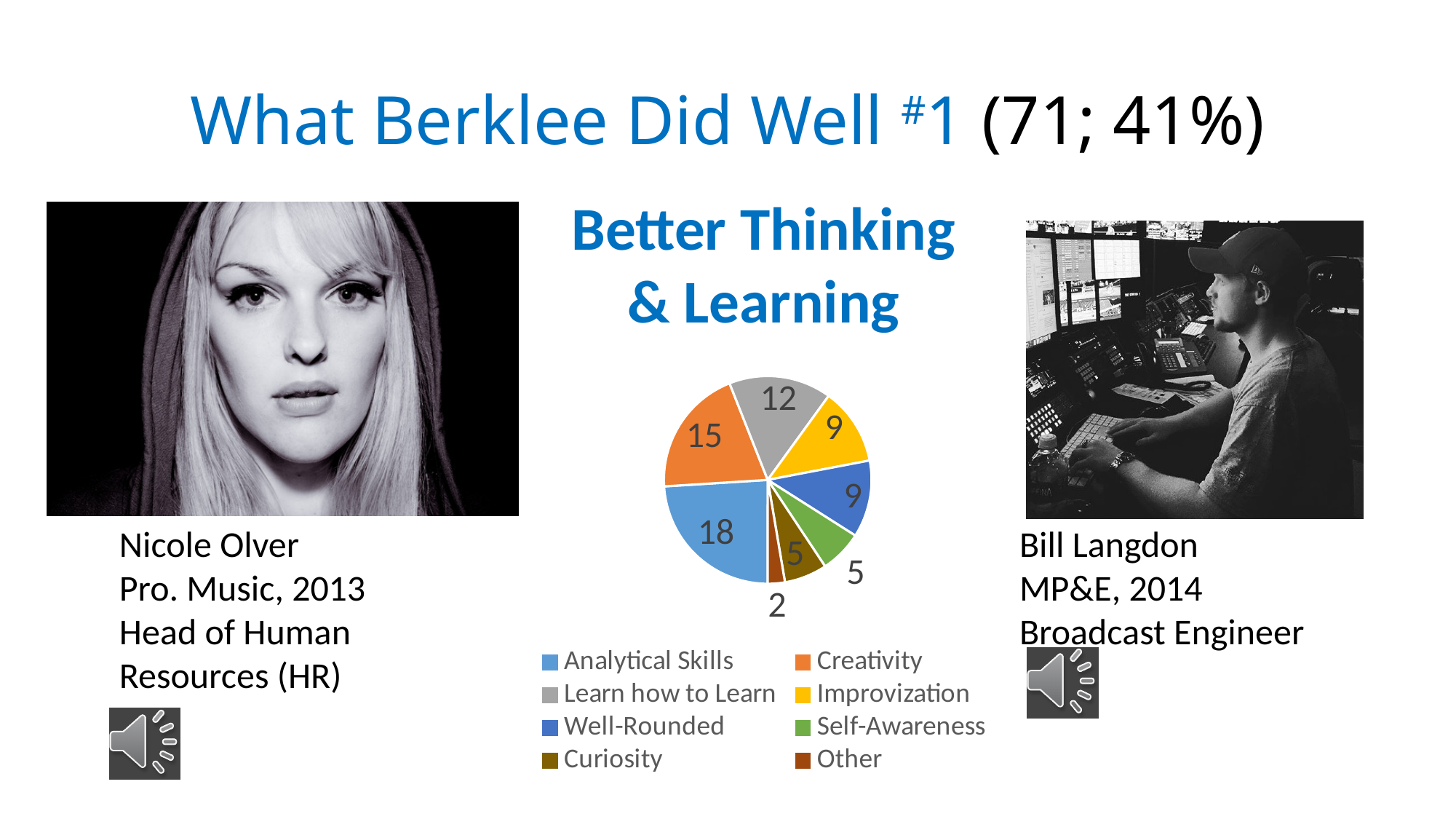
What is the value for Learn how to Learn in the pie chart? 12 What is the value for Creativity in the pie chart? 15 Which category has the largest slice in the pie chart? Analytical Skills Which is larger, the value for Learn how to Learn or the value for Improvization? Learn how to Learn What share of the pie does Analytical Skills represent? 24% What colour is the Creativity slice in the pie chart? orange What is the value for Other in the pie chart? 2 How many categories does the pie chart legend list? 8 What is the difference between the values for Analytical Skills and Creativity? 3 What is the value for Analytical Skills in the pie chart? 18 Which category has the smallest slice in the pie chart? Other What type of chart is shown on the slide? pie chart